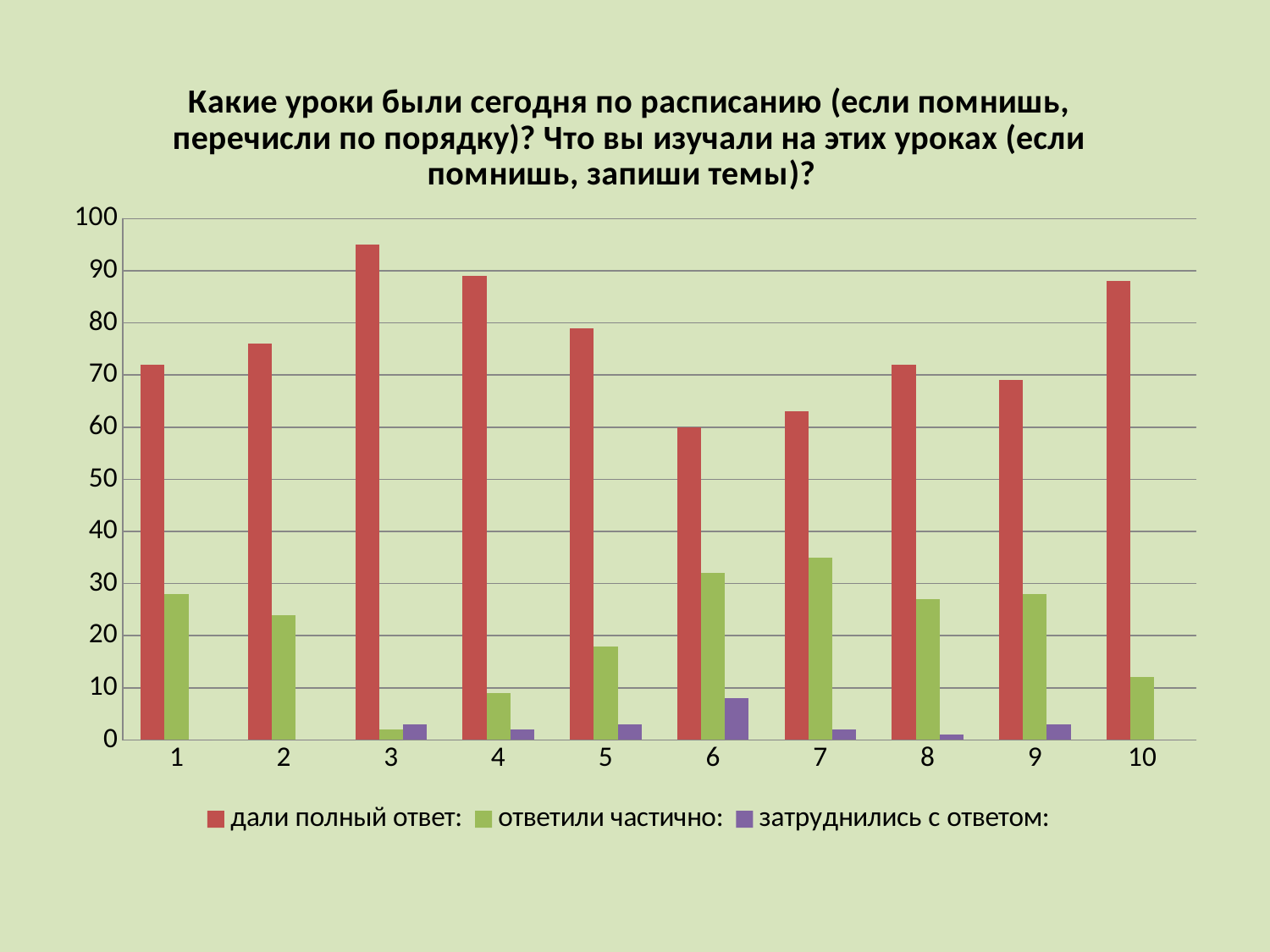
Which is larger: 'дали полный ответ:' in category 3 or in category 10? category 3 Which is larger: 'ответили частично:' in category 1 or in category 4? category 1 Is the value for 'ответили частично:' in category 1 greater or less than 30? less How many categories are shown on the x axis? 10 What kind of chart is shown on the slide? bar chart How many series does the legend list? 3 Is the value for 'дали полный ответ:' in category 3 greater or less than 90? greater Is the value for 'дали полный ответ:' in category 10 greater or less than 80? greater What colour are the bars for the series 'ответили частично:'? green Which category has the highest value for 'затруднились с ответом:'? 6 Which category has the lowest value for 'ответили частично:'? 3 Which category has the highest value for 'дали полный ответ:'? 3